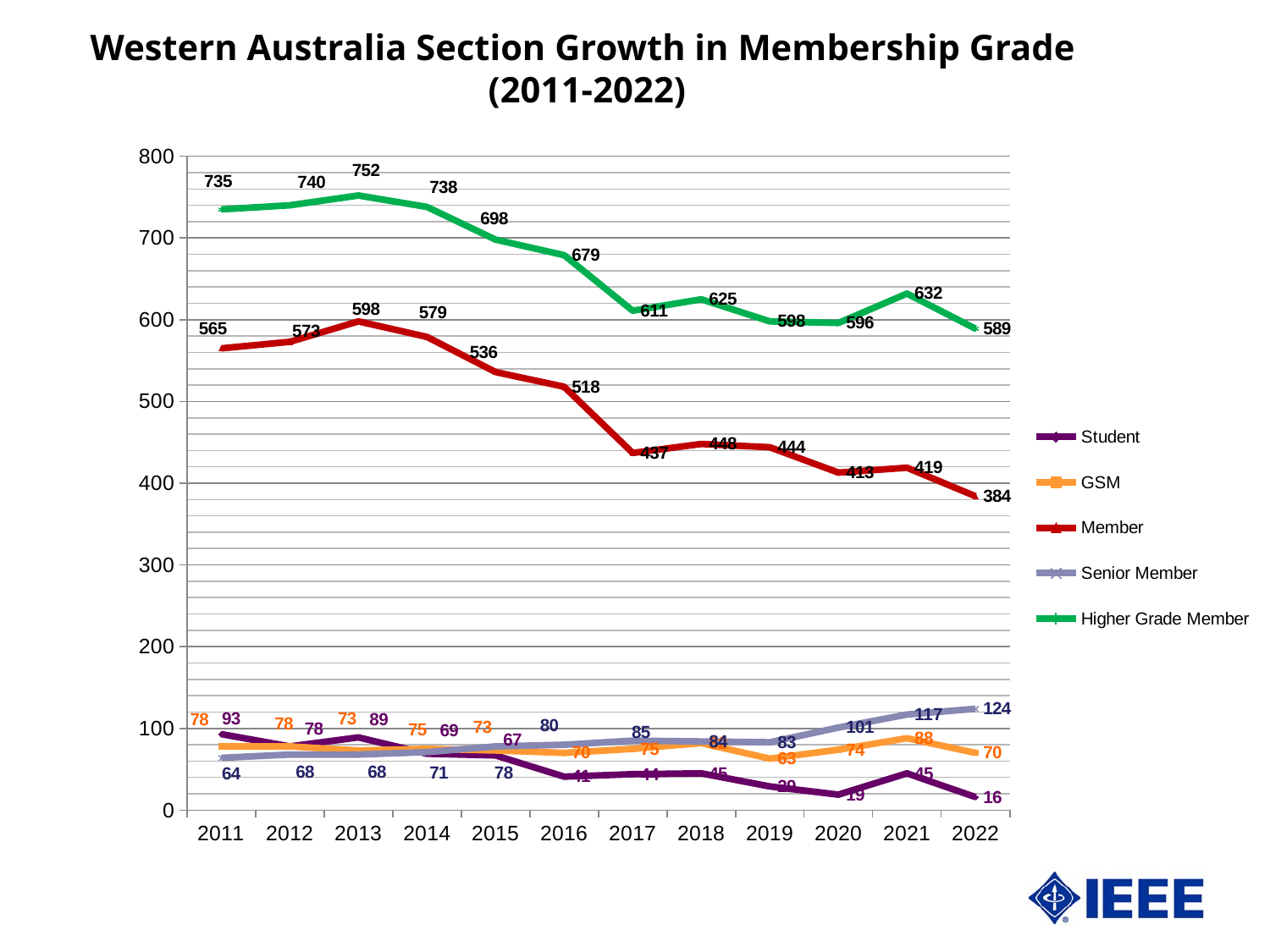
What is the value for Senior Member in 2022? 124 What is the value for Student in 2022? 16 In which year is the Higher Grade Member value highest? 2013 What is the value for Member in 2022? 384 Is the value for Member in 2016 greater or less than 500? greater What is the value for Higher Grade Member in 2013? 752 Which is larger in 2021: the Senior Member value or the GSM value? Senior Member What kind of chart is shown on the slide? Line chart What is the difference between the Higher Grade Member values in 2011 and 2022? 146 How many series does the legend list? 5 In which year is the Member value lowest? 2022 How many years are shown on the x axis? 12